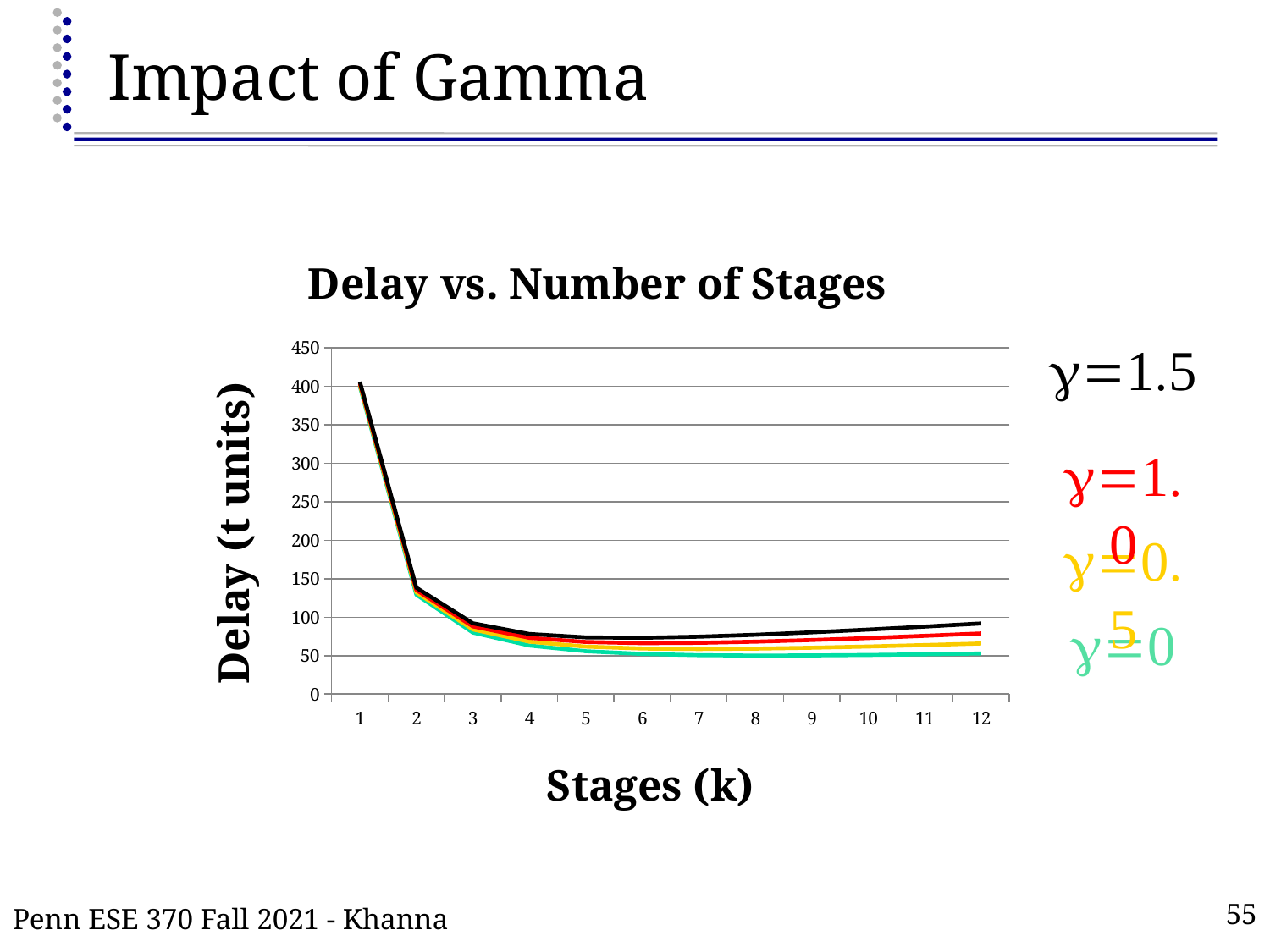
What is the label of the x axis? Stages (k) Is the delay at stage 6 for the black (γ=1.5) line greater or less than 100? less Is the delay at stage 2 for the black (γ=1.5) line greater or less than 100? greater At which stage is the delay highest for all lines? 1 How many stage values are plotted along the x axis? 12 What is the title of the chart? Delay vs. Number of Stages Do the delay values rise or fall from stage 1 to stage 3? fall At stage 12, which line has the larger delay, the black (γ=1.5) line or the green (γ=0) line? black (γ=1.5) Do the delay values for the black (γ=1.5) line rise or fall from stage 8 to stage 12? rise What kind of chart is shown on the slide? line chart Is the delay at stage 12 for the green (γ=0) line greater or less than 100? less